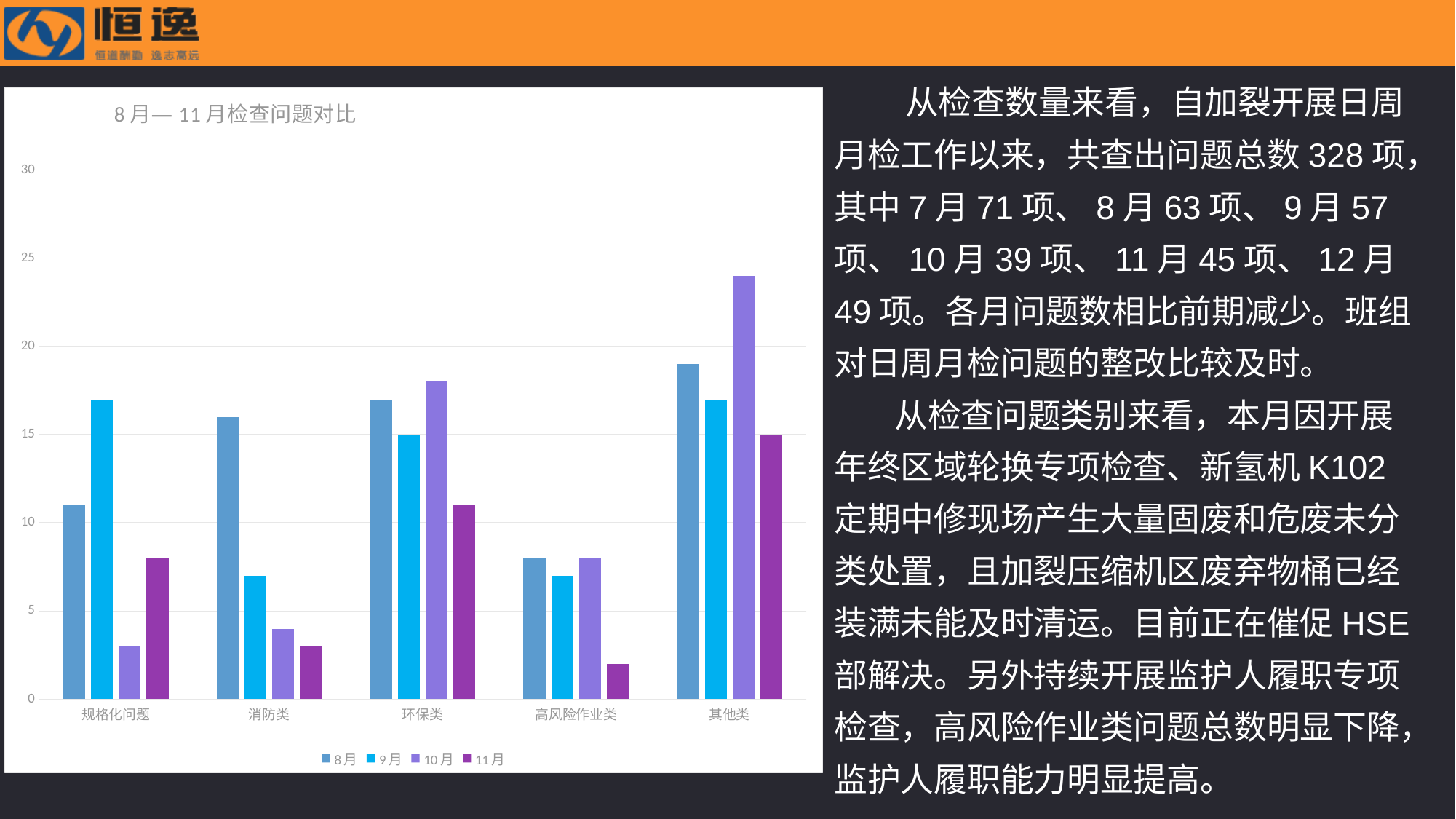
Is the 10月 value for 规格化问题 greater or less than 5? less What is the title of the chart? 8月—11月检查问题对比 For 规格化问题, which is larger: the 8月 value or the 9月 value? 9月 Which category has the lowest 11月 bar? 高风险作业类 Is the 8月 value for 其他类 greater or less than 15? greater Which category has the highest 8月 bar? 其他类 What kind of chart is shown on the slide? bar chart How many categories are shown on the x axis? 5 Is the 10月 value for 其他类 greater or less than 20? greater Which category has the highest 10月 bar? 其他类 For 消防类, which is larger: the 8月 value or the 9月 value? 8月 How many series does the legend list? 4